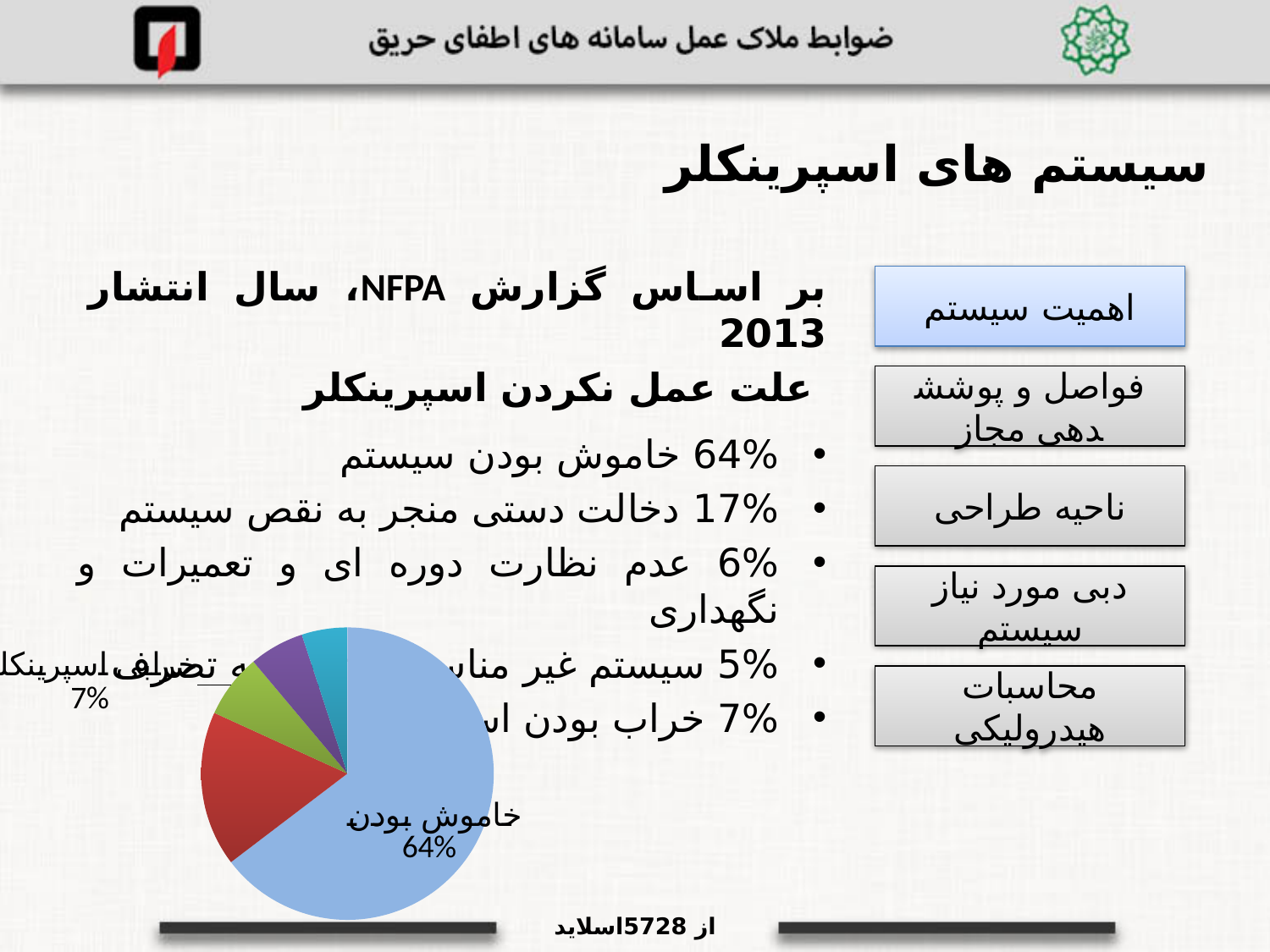
Does the slice labelled خاموش بودن take up more or less than half of the pie? more What colour is the slice labelled خاموش بودن in the pie chart? blue How many slices does the pie chart have? 5 What kind of chart is shown at the bottom left of the slide? pie chart Besides 64%, what other percentage value is printed as a data label on the pie chart? 7% What share of the pie does the slice labelled خاموش بودن represent? 64% Which is larger in the pie chart: the blue slice (خاموش بودن) or the red slice? the blue slice (خاموش بودن) Which slice of the pie chart is the largest? خاموش بودن What percentage is printed on the data label for خاموش بودن in the pie chart? 64%